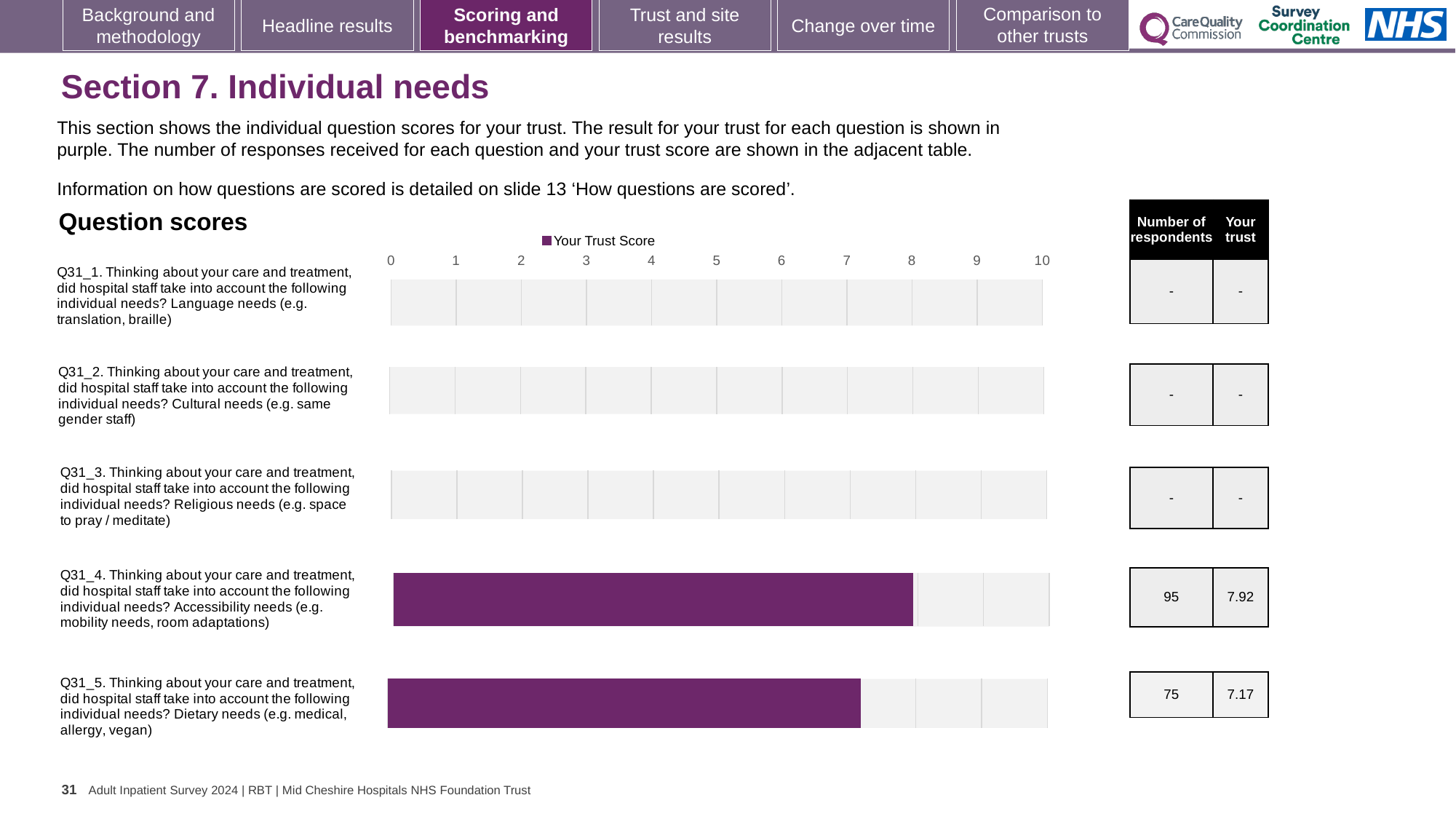
How many series does the chart legend list? 1 What kind of chart is shown on the slide? Bar chart What is the name of the series shown in the chart legend? Your Trust Score How many questions are listed on the chart? 5 How many respondents answered Q31_4 (Accessibility needs)? 95 Is the trust score for Q31_5 (Dietary needs) greater or less than 8? less How many respondents answered Q31_5 (Dietary needs)? 75 What is the trust score for Q31_5 (Dietary needs)? 7.17 Which question has the highest trust score shown on the chart? Q31_4 (Accessibility needs) What is the difference between the trust scores for Q31_4 and Q31_5? 0.75 What is the trust score for Q31_4 (Accessibility needs)? 7.92 Which has the larger trust score, Q31_4 (Accessibility needs) or Q31_5 (Dietary needs)? Q31_4 (Accessibility needs)